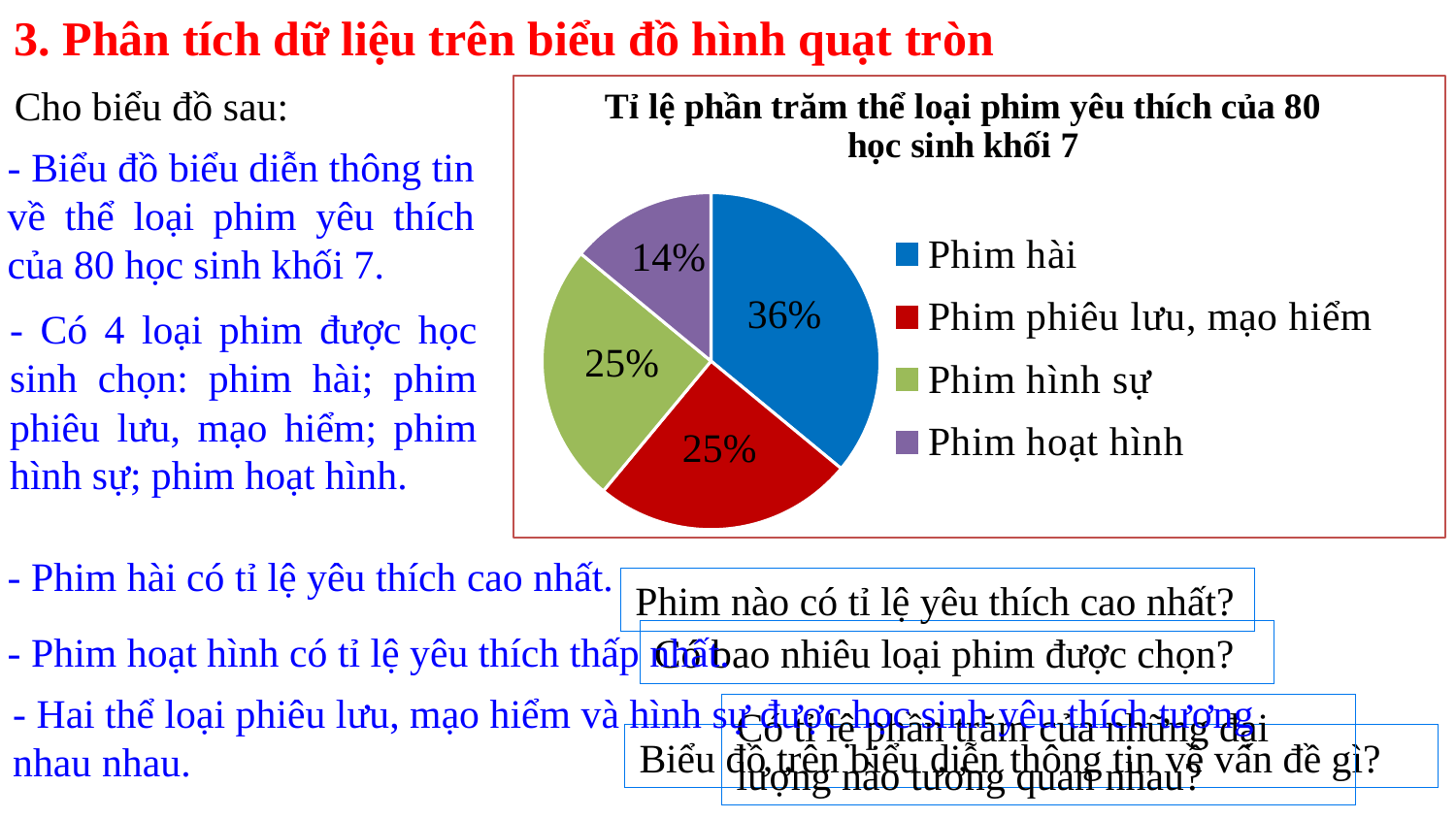
What is the title of the pie chart? Tỉ lệ phần trăm thể loại phim yêu thích của 80 học sinh khối 7 What is the difference in percentage points between Phim hài and Phim hoạt hình? 22% What percentage of the pie chart is for Phim hài? 36% Which film genre has the smallest share of the pie chart? Phim hoạt hình What percentage of the pie chart is for Phim hình sự? 25% Which film genre has the largest share of the pie chart? Phim hài What kind of chart is shown on the slide? Pie chart Which is larger, the share for Phim hài or the share for Phim hình sự? Phim hài What percentage of the pie chart is for Phim phiêu lưu, mạo hiểm? 25% What percentage of the pie chart is for Phim hoạt hình? 14% How many slices does the pie chart have? 4 Which colour represents Phim phiêu lưu, mạo hiểm in the pie chart? Red